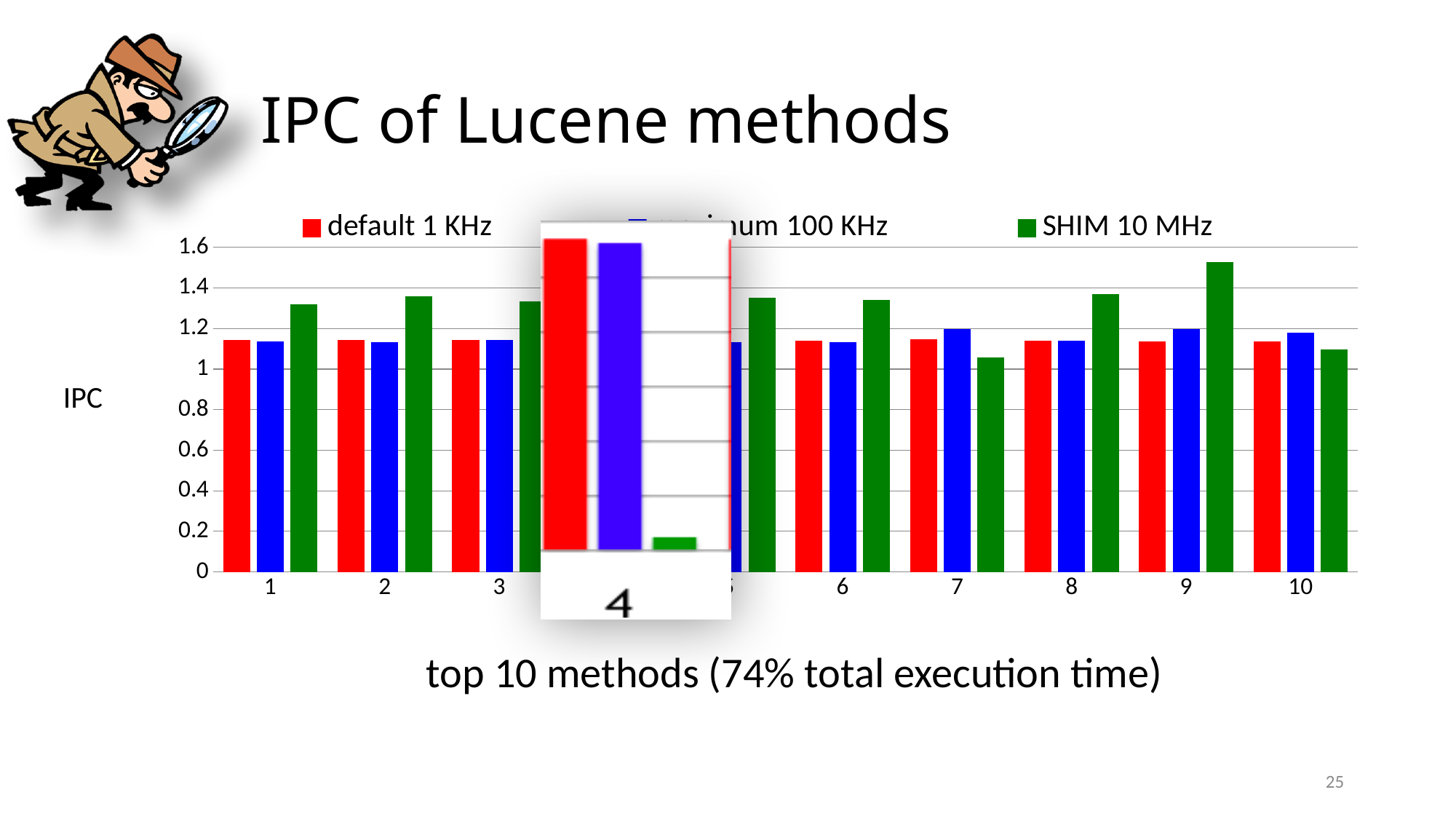
Is the SHIM 10 MHz value for method 10 greater or less than 1.2? less What is the label on the y axis of the chart? IPC Is the default 1 KHz value for method 1 greater or less than 1? greater For method 7, which is larger: the default 1 KHz value or the SHIM 10 MHz value? default 1 KHz What kind of chart is shown on the slide? bar chart How many methods are shown along the x axis? 10 How many series does the legend list? 3 Which method has the highest SHIM 10 MHz value? 9 Is the SHIM 10 MHz value for method 7 greater or less than 1.2? less For method 1, which is larger: the default 1 KHz value or the SHIM 10 MHz value? SHIM 10 MHz Which method has the lowest SHIM 10 MHz value? 4